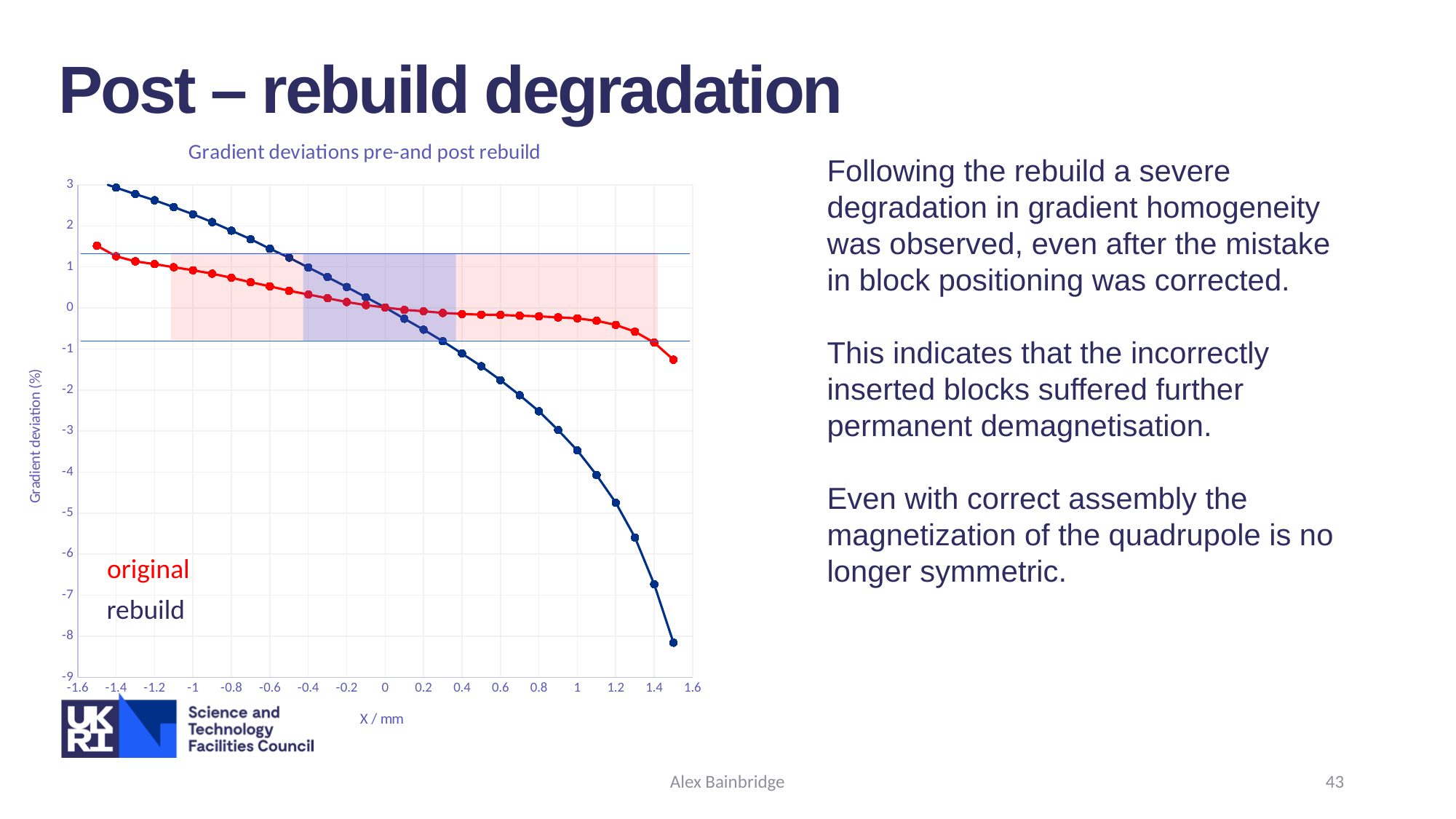
At X = 1 mm, which series has the higher gradient deviation, original or rebuild? original Does the rebuild series rise or fall as X increases? fall Is the rebuild value at X = -1.5 mm greater or less than 2? greater Is the rebuild value at X = 1 mm greater or less than -3? less What is the label of the y axis? Gradient deviation (%) Is the rebuild value at X = 1.4 mm greater or less than -6? less Does the original series rise or fall as X increases? fall What is the title of the chart? Gradient deviations pre-and post rebuild At X = -1 mm, which series has the higher gradient deviation, original or rebuild? rebuild How many data series are plotted on the chart? 2 What kind of chart is shown on the slide? line chart